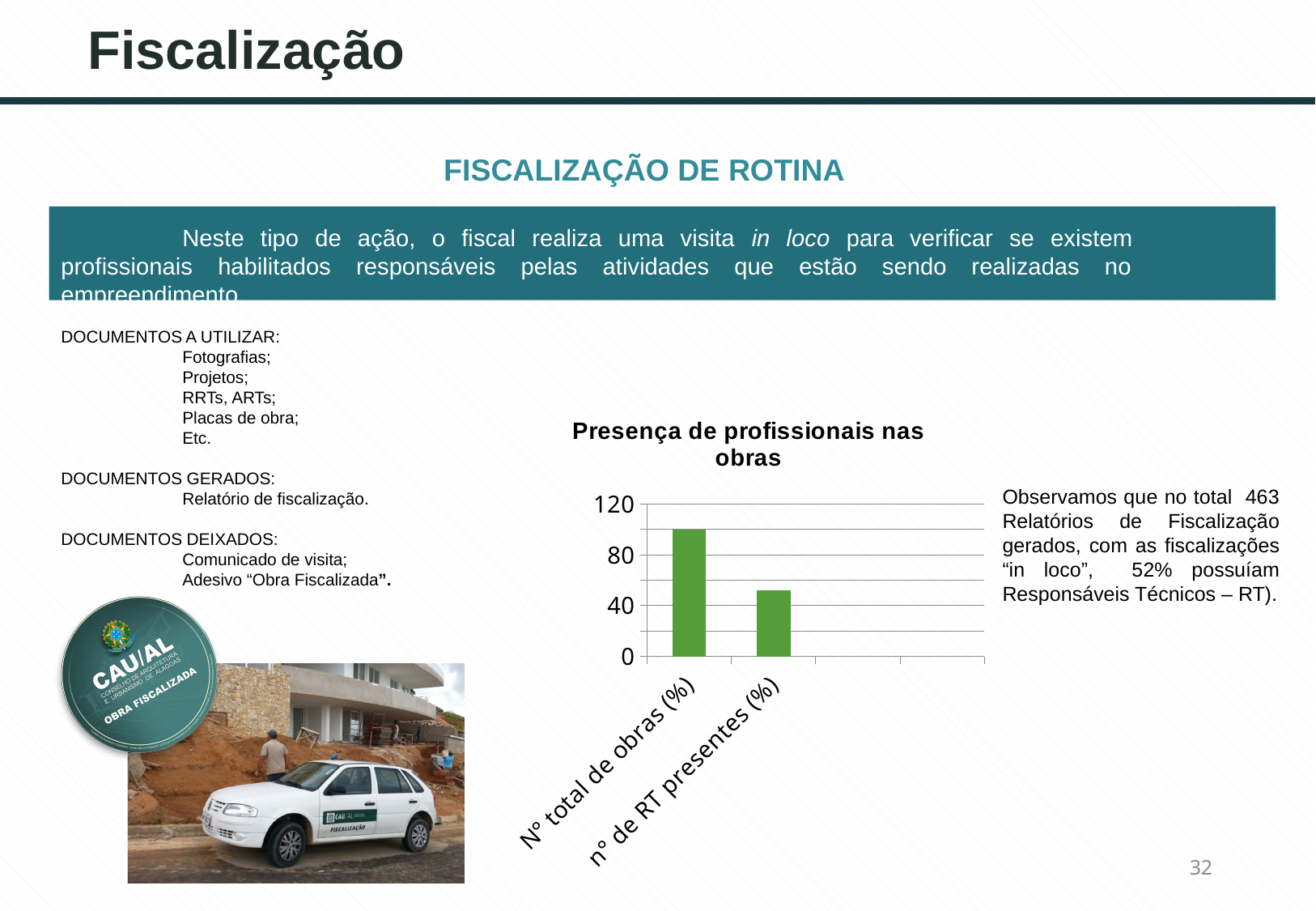
In the "Presença de profissionais nas obras" chart, is the value for "nº de RT presentes (%)" greater or less than 40? greater What is the highest tick value shown on the vertical axis of the "Presença de profissionais nas obras" chart? 120 How many categories are plotted in the "Presença de profissionais nas obras" chart? 2 In the "Presença de profissionais nas obras" chart, is the value for "nº de RT presentes (%)" greater or less than 80? less Which category has the lowest bar in the "Presença de profissionais nas obras" chart? nº de RT presentes (%) In the "Presença de profissionais nas obras" chart, is the value for "Nº total de obras (%)" greater or less than 80? greater In the "Presença de profissionais nas obras" chart, which is larger: "Nº total de obras (%)" or "nº de RT presentes (%)"? Nº total de obras (%) Do the bars in the "Presença de profissionais nas obras" chart rise or fall from left to right? fall What type of chart is shown under the title "Presença de profissionais nas obras"? bar chart Which category has the highest bar in the "Presença de profissionais nas obras" chart? Nº total de obras (%) What is the title of the chart on the slide? Presença de profissionais nas obras